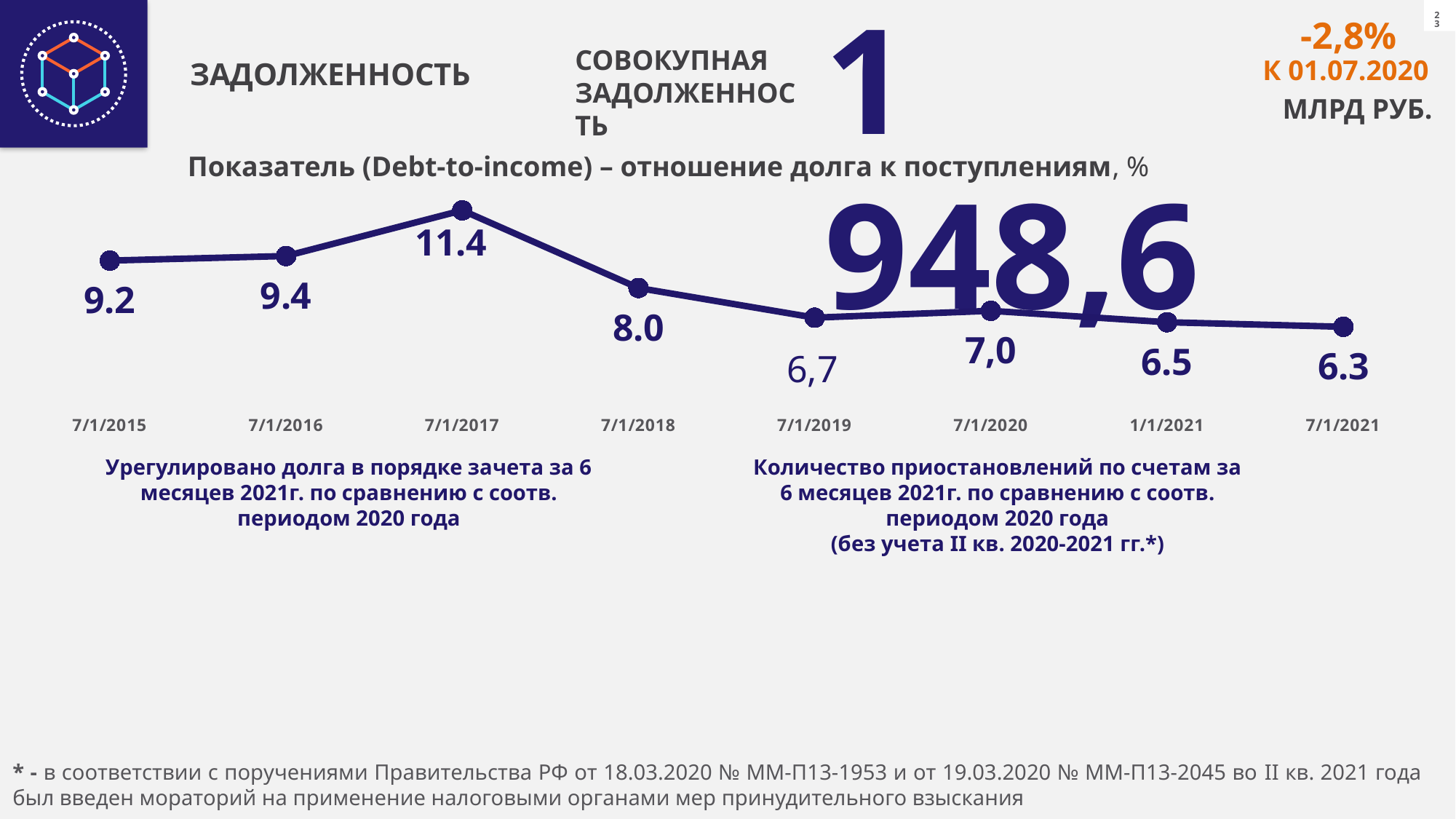
What is the Debt-to-income value for 7/1/2021? 6.3 Which date has the highest Debt-to-income value? 7/1/2017 What is the Debt-to-income value for 7/1/2017? 11.4 What is the Debt-to-income value for 7/1/2019? 6,7 How many data points are plotted on the line chart? 8 Which is larger, the Debt-to-income value for 7/1/2016 or for 1/1/2021? 7/1/2016 What is the difference between the Debt-to-income values for 7/1/2017 and 7/1/2018? 3.4 What type of chart is shown on the slide? line chart What is the title of the line chart? Показатель (Debt-to-income) – отношение долга к поступлениям, % What is the Debt-to-income value for 7/1/2015? 9.2 Which date has the lowest Debt-to-income value? 7/1/2021 Does the Debt-to-income value rise or fall from 7/1/2017 to 7/1/2021? fall